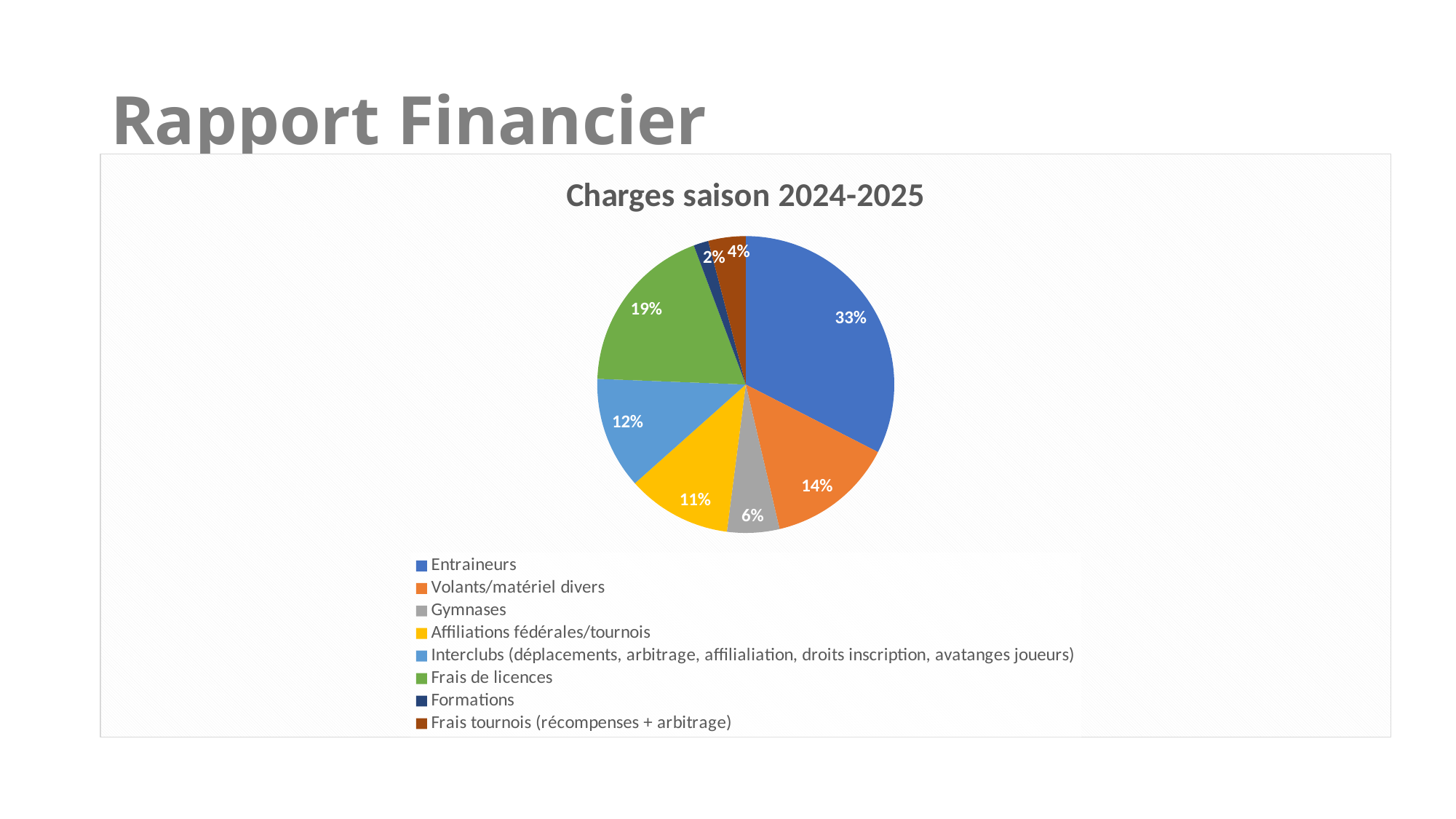
What is the difference in percentage points between Volants/matériel divers and Affiliations fédérales/tournois? 3 What share of the pie does Frais de licences represent? 19% Which is larger, the share for Interclubs or the share for Frais tournois (récompenses + arbitrage)? Interclubs What share of the pie does Gymnases represent? 6% What colour is the slice for Affiliations fédérales/tournois? yellow What type of chart is shown on the slide? pie chart Which category has the smallest share of the pie? Formations What is the title of the chart? Charges saison 2024-2025 How many categories does the legend list? 8 What share of the pie does Formations represent? 2% Which category has the largest share of the pie? Entraineurs